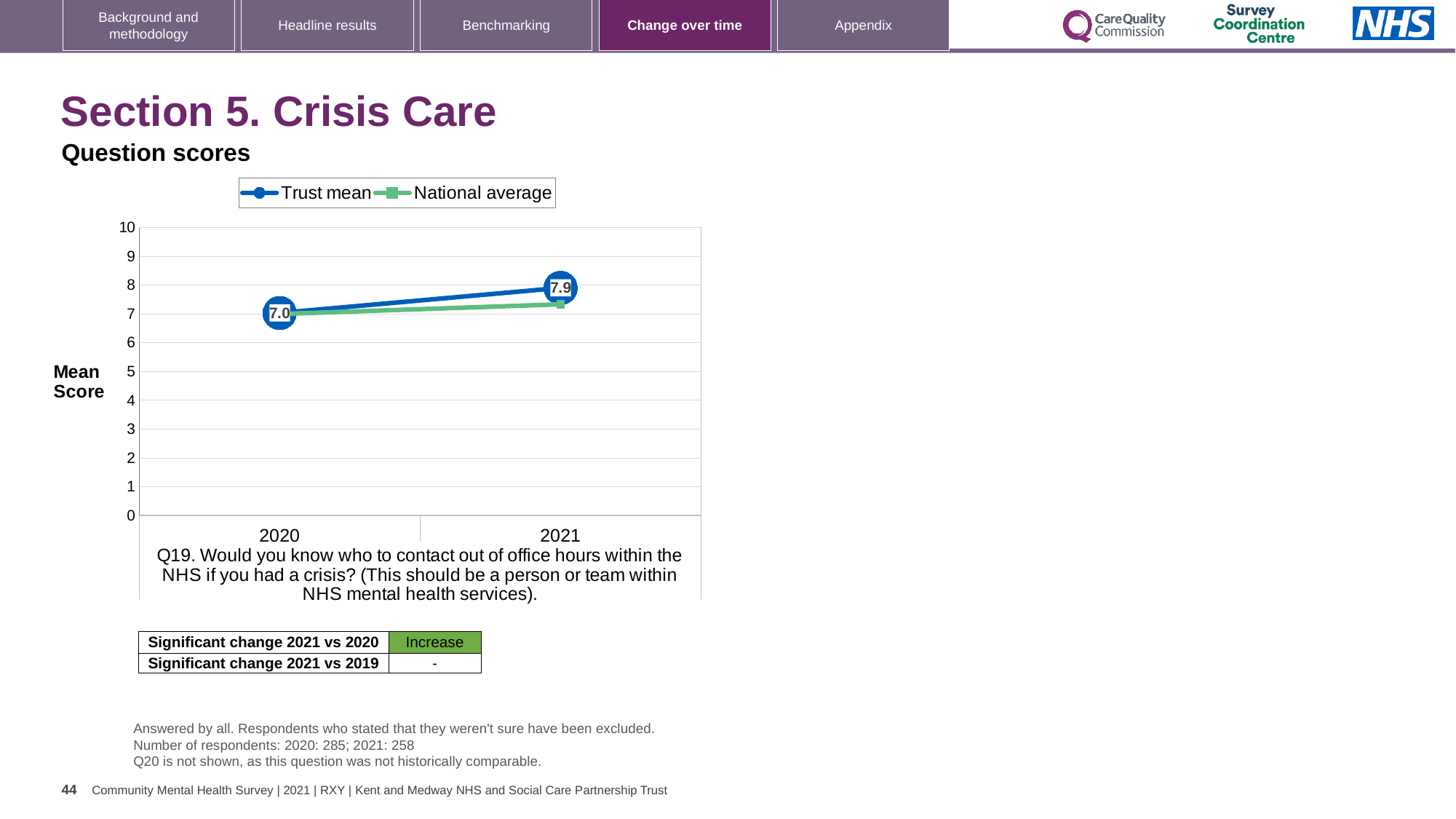
By how much did the Trust mean score change from 2020 to 2021? 0.9 In which year is the Trust mean score highest? 2021 Does the Trust mean score rise or fall from 2020 to 2021? rise How many years are plotted on the x axis? 2 Is the National average value for 2021 greater or less than 8? less In 2021, which is larger: the Trust mean or the National average? Trust mean How many series does the legend list? 2 What kind of chart is shown on the slide? line chart What is the Trust mean score for 2020? 7.0 In which year is the Trust mean score lowest? 2020 What is the label on the y axis of the chart? Mean Score What is the Trust mean score for 2021? 7.9